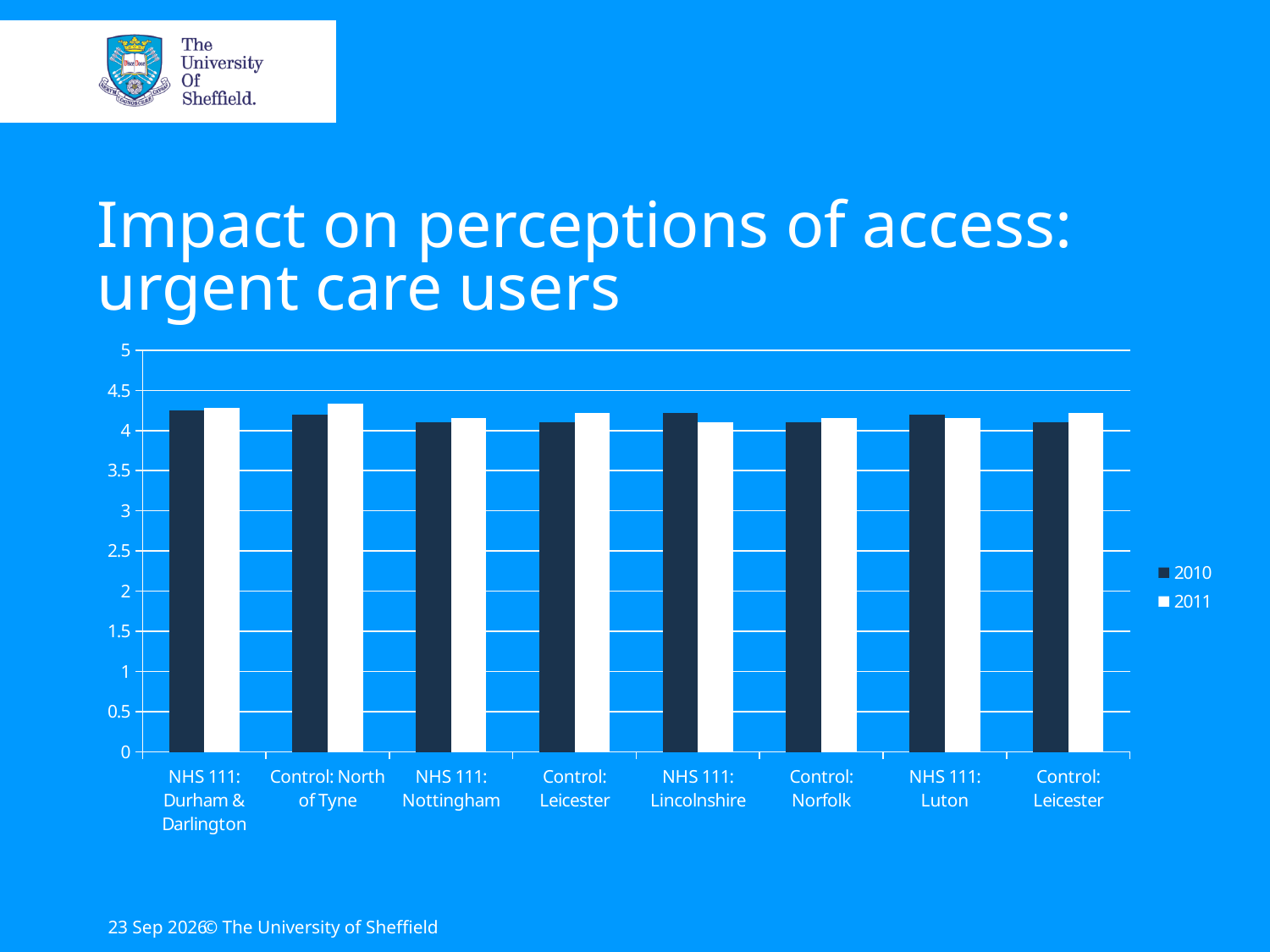
What is the title of the slide containing the chart? Impact on perceptions of access: urgent care users Is the 2011 value for Control: North of Tyne greater or less than 4.5? less Is the 2010 value for NHS 111: Nottingham greater or less than 3.5? greater What is the highest value shown on the y axis? 5 What kind of chart is shown on the slide? bar chart Is the 2010 value for Control: Norfolk greater or less than 3? greater Which years are listed in the chart legend? 2010 and 2011 Which is larger for 2010: NHS 111: Durham & Darlington or NHS 111: Nottingham? NHS 111: Durham & Darlington How many categories are shown along the x axis? 8 How many series does the legend list? 2